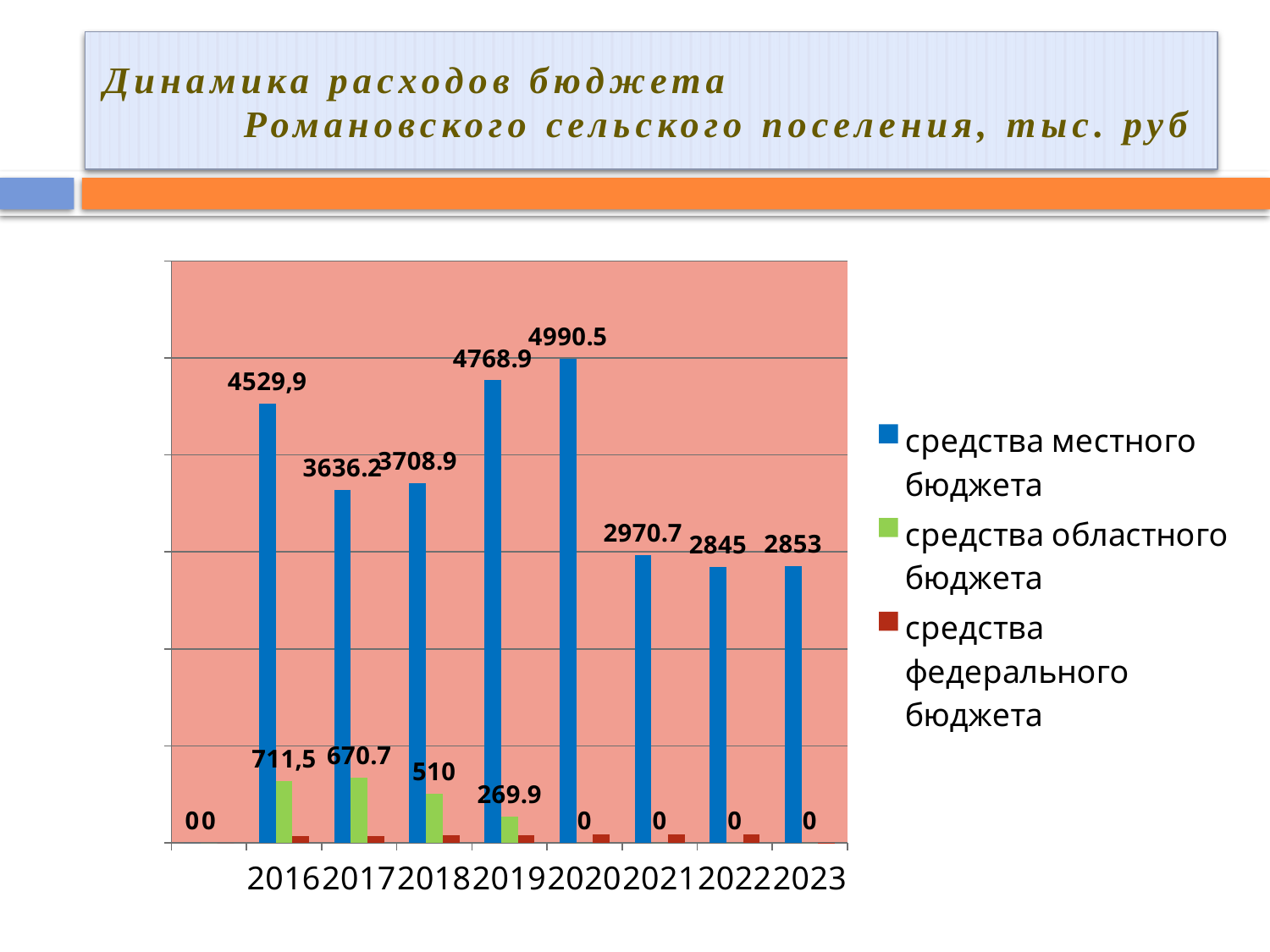
What is the value of средства областного бюджета for 2018? 510 What is the difference between средства местного бюджета in 2020 and 2019? 221.6 Which year has the larger value of средства местного бюджета, 2017 or 2018? 2018 Does средства областного бюджета rise or fall from 2016 to 2019? fall What type of chart is shown on the slide? bar chart What is the value of средства местного бюджета for 2016? 4529,9 What is the value of средства областного бюджета for 2019? 269.9 In which year is средства местного бюджета highest? 2020 How many series does the legend list? 3 In which year is средства областного бюджета highest? 2016 In which year is средства местного бюджета lowest? 2022 What is the value of средства местного бюджета for 2020? 4990.5